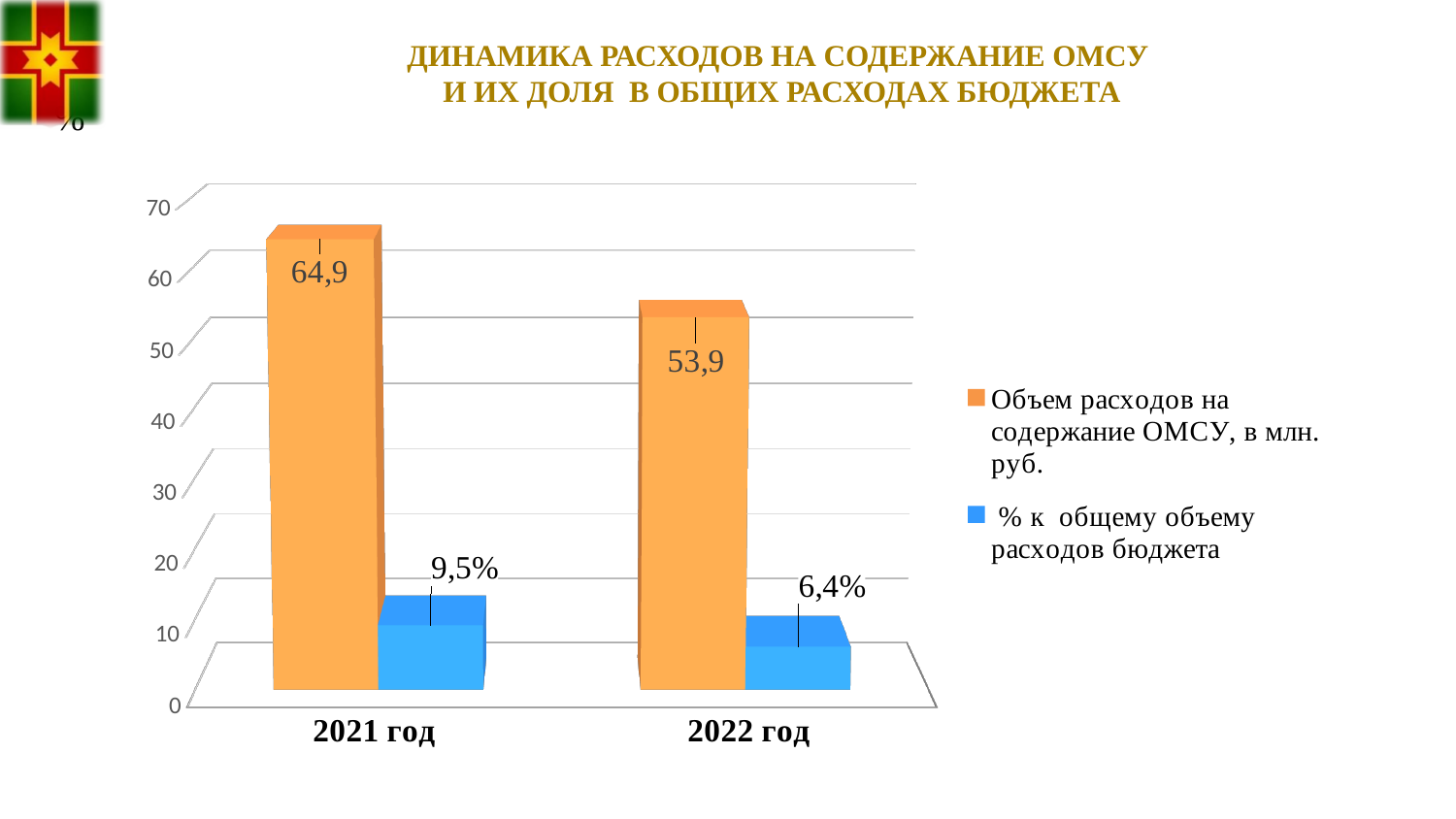
What is the value of '% к общему объему расходов бюджета' for 2021 год? 9,5% What is the value of 'Объем расходов на содержание ОМСУ, в млн. руб.' for 2022 год? 53,9 What is the difference between the '% к общему объему расходов бюджета' values for 2021 год and 2022 год? 3,1% What is the value of '% к общему объему расходов бюджета' for 2022 год? 6,4% Which year has the lower value for '% к общему объему расходов бюджета'? 2022 год What kind of chart is shown on the slide? bar chart Which year has the higher value for 'Объем расходов на содержание ОМСУ, в млн. руб.'? 2021 год How many categories (years) are shown on the x axis? 2 Is the value for 'Объем расходов на содержание ОМСУ, в млн. руб.' in 2022 год greater or less than 60? less What is the value of 'Объем расходов на содержание ОМСУ, в млн. руб.' for 2021 год? 64,9 How many series does the legend list? 2 By how much did 'Объем расходов на содержание ОМСУ, в млн. руб.' decrease from 2021 год to 2022 год? 11,0